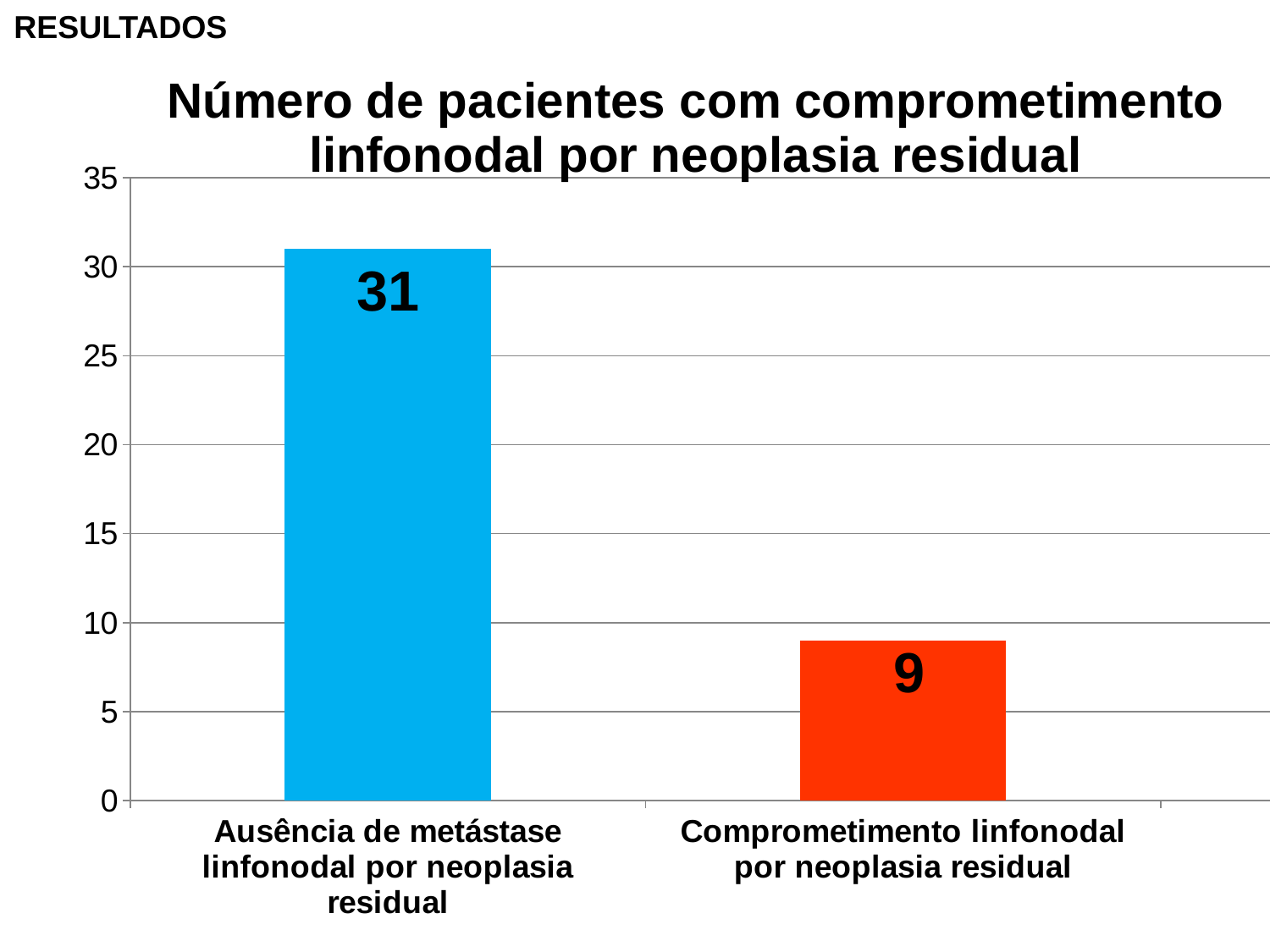
What is the difference between the values for "Ausência de metástase linfonodal por neoplasia residual" and "Comprometimento linfonodal por neoplasia residual"? 22 Is the value for "Ausência de metástase linfonodal por neoplasia residual" greater or less than 30? greater What is the title of the chart? Número de pacientes com comprometimento linfonodal por neoplasia residual Is the value for "Comprometimento linfonodal por neoplasia residual" greater or less than 10? less How many categories are shown in the chart? 2 What is the value for "Ausência de metástase linfonodal por neoplasia residual"? 31 What is the value for "Comprometimento linfonodal por neoplasia residual"? 9 Which category has the highest value? Ausência de metástase linfonodal por neoplasia residual Which is larger: the value for "Ausência de metástase linfonodal por neoplasia residual" or for "Comprometimento linfonodal por neoplasia residual"? Ausência de metástase linfonodal por neoplasia residual What kind of chart is shown on the slide? bar chart Which category has the lowest value? Comprometimento linfonodal por neoplasia residual What colour is the bar for "Comprometimento linfonodal por neoplasia residual"? red